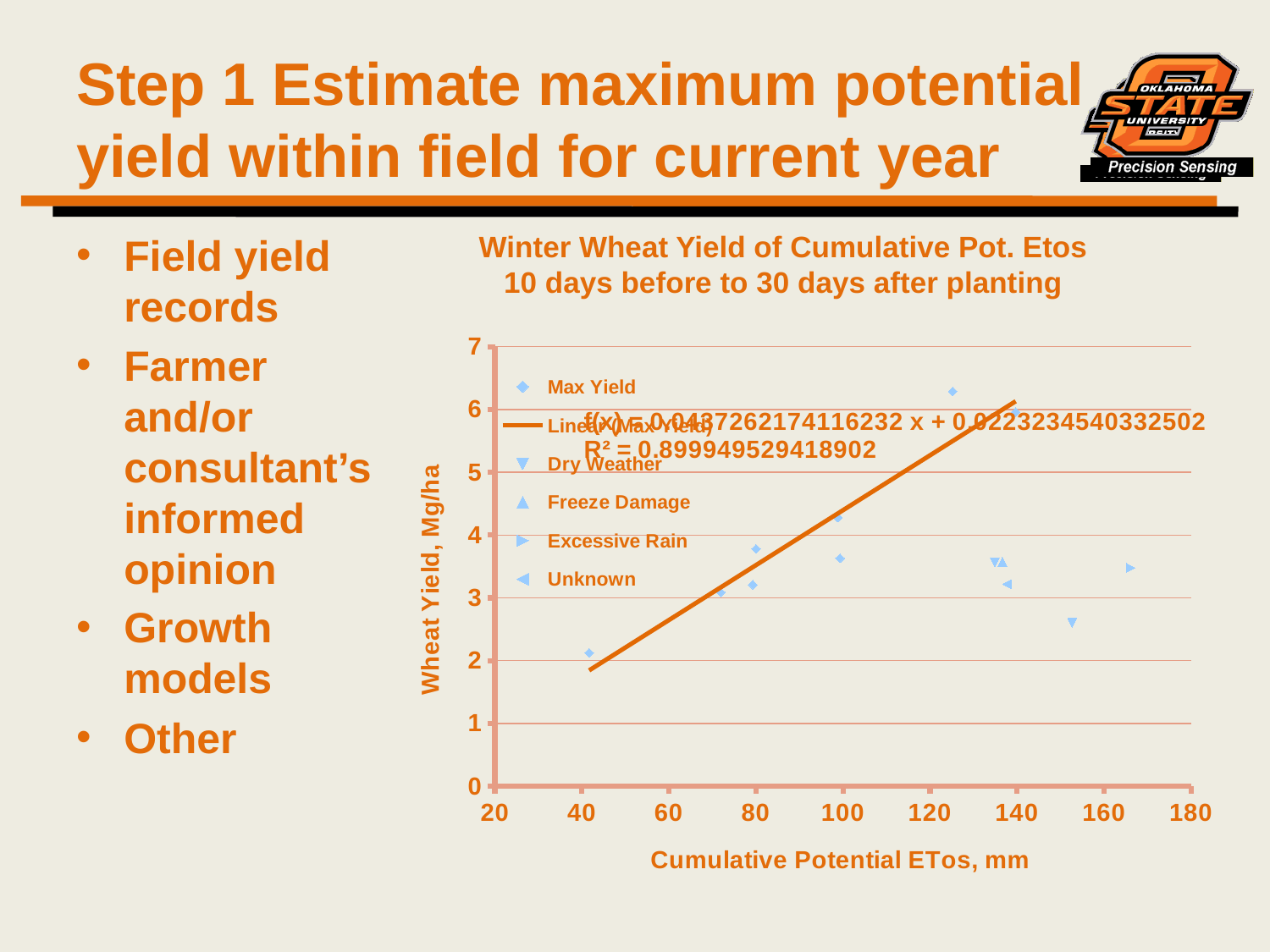
What is the label of the x axis of the chart? Cumulative Potential ETos, mm How many entries does the chart legend list? 6 What kind of chart is shown on the slide? Scatter chart Is the lowest Max Yield point on the chart greater or less than 3 Mg/ha? less Is the highest Max Yield point on the chart greater or less than 5 Mg/ha? greater What is the highest value shown on the y axis of the chart? 7 What is the lowest value shown on the x axis of the chart? 20 What R² value is printed on the chart for the linear fit? 0.899949529418902 Does the Max Yield trendline rise or fall as Cumulative Potential ETos increases? Rises What is the title of the chart? Winter Wheat Yield of Cumulative Pot. Etos 10 days before to 30 days after planting Which legend entry is represented by the solid line on the chart? Linear (Max Yield)